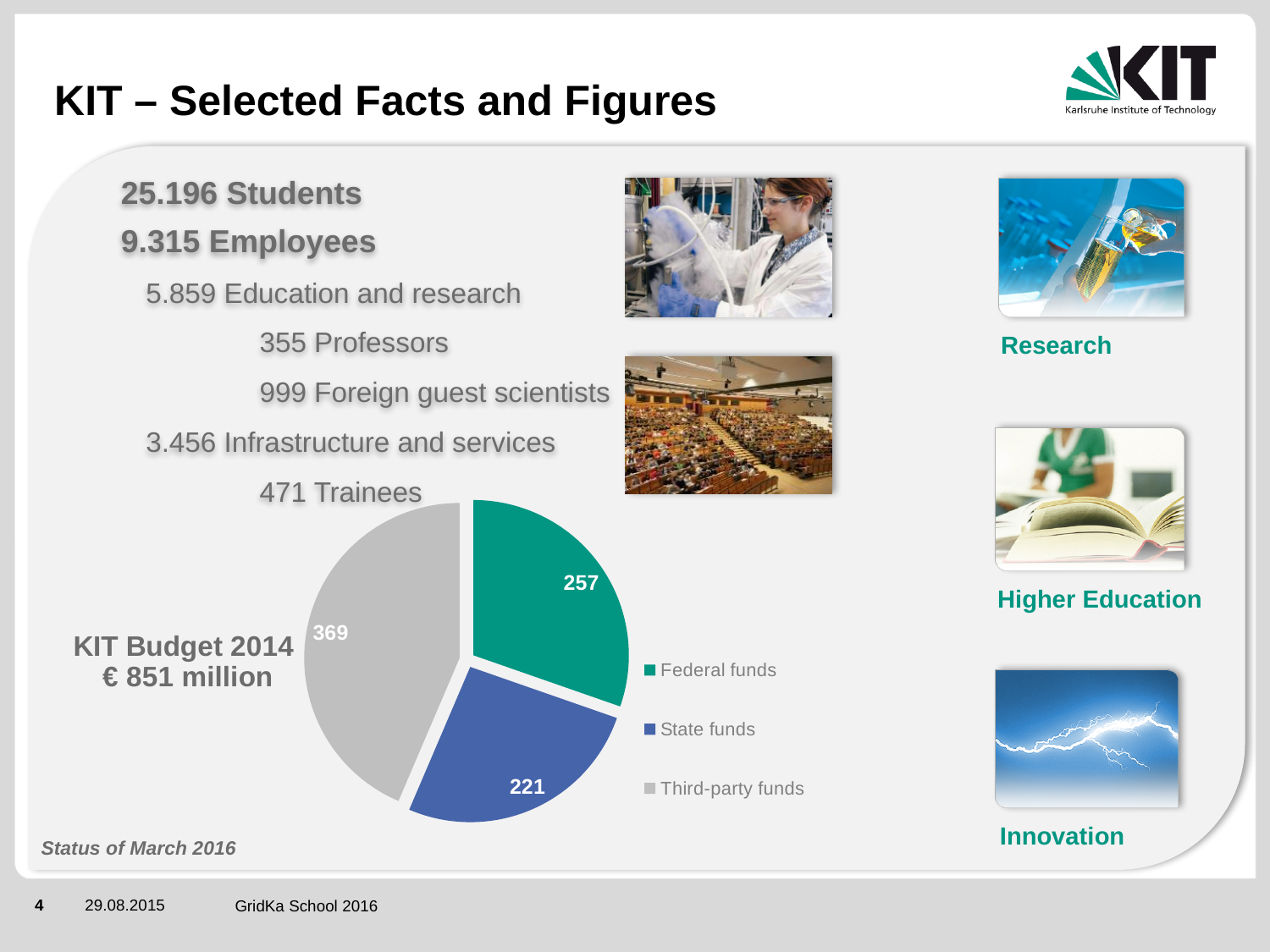
Which slice of the pie chart has the largest value? Third-party funds What is the sum of the three values labelled on the pie chart? 847 In the pie chart, what is the value labelled for State funds? 221 How many slices does the pie chart have? 3 In the pie chart, what is the value labelled for Third-party funds? 369 In the pie chart, which is larger: Federal funds or State funds? Federal funds In the pie chart, how much larger is the Third-party funds value than the Federal funds value? 112 What kind of chart is shown on the slide? Pie chart In the pie chart, what is the value labelled for Federal funds? 257 In the pie chart, what is the difference between the Federal funds value and the State funds value? 36 Which slice of the pie chart has the smallest value? State funds What colour is the Federal funds slice in the pie chart? Green